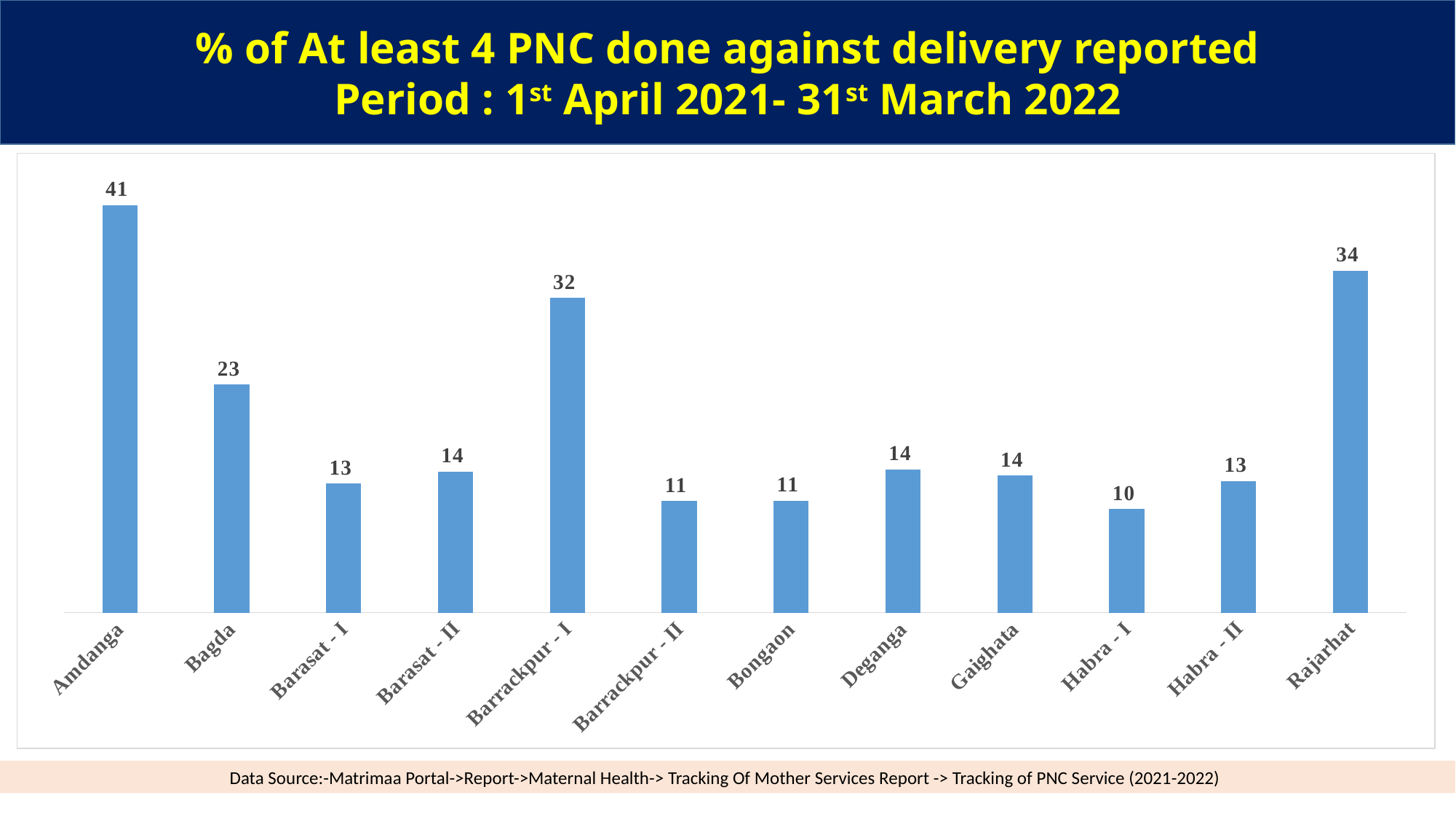
What is the value for Amdanga? 41 Which block has the lowest value? Habra - I What kind of chart is shown on the slide? Bar chart What period does the chart title say the data covers? 1st April 2021- 31st March 2022 What is the value for Habra - I? 10 What is the difference between the values for Amdanga and Bagda? 18 Which is larger, the value for Bagda or the value for Deganga? Bagda Which block has the highest value? Amdanga How many blocks are shown on the chart? 12 What is the value for Rajarhat? 34 What is the value for Barrackpur - I? 32 What is the difference between the values for Rajarhat and Barrackpur - I? 2